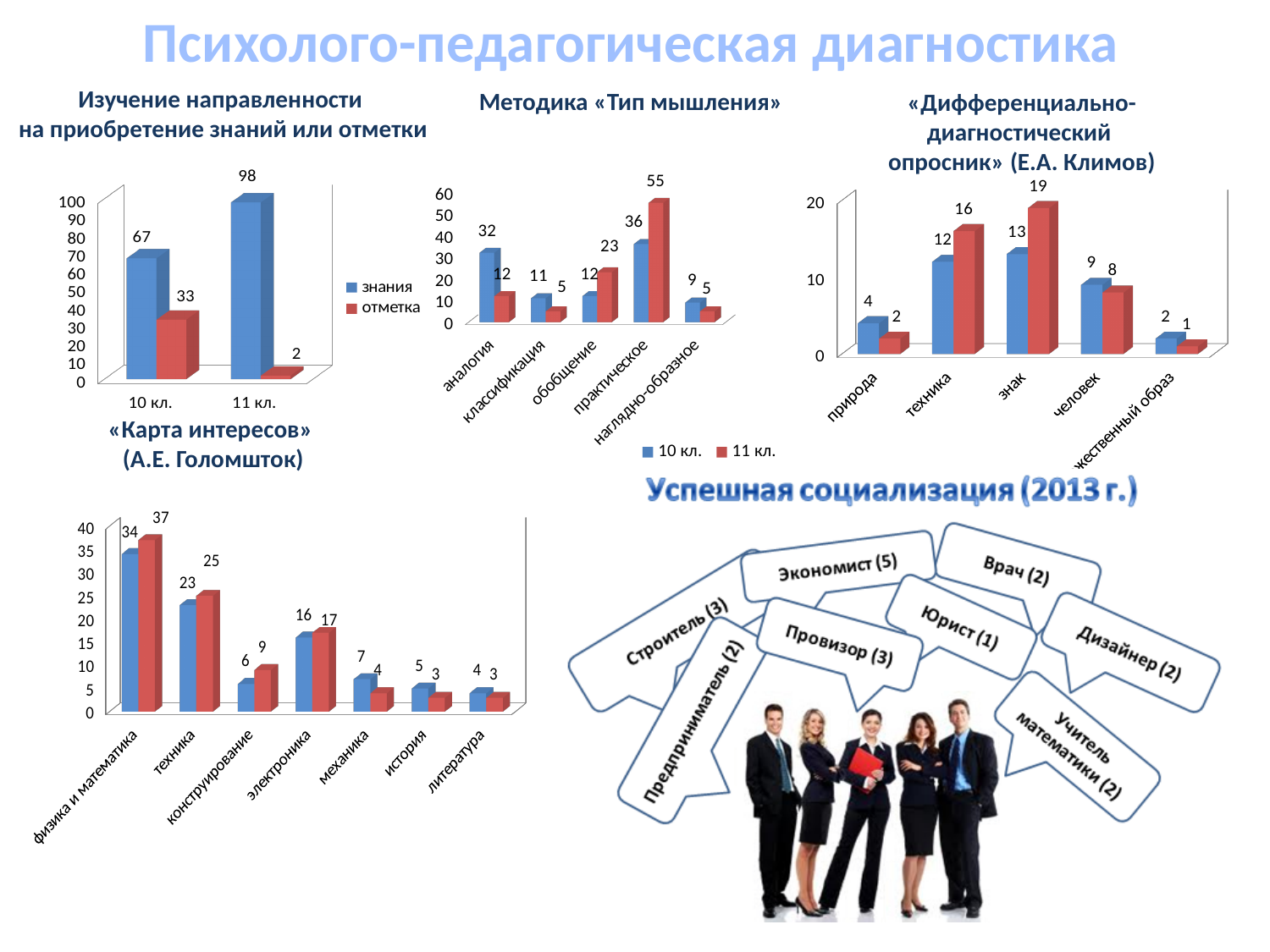
In the chart «Методика «Тип мышления»», how many categories are shown on the x axis? 5 In the chart «Карта интересов» (А.Е. Голомшток), what is the difference between the red and blue bars for «конструирование»? 3 In the chart «Методика «Тип мышления»», which category has the highest value for 10 кл.? практическое In the chart «Карта интересов» (А.Е. Голомшток), what is the value of the red bar for «техника»? 25 In the chart «Дифференциально-диагностический опросник» (Е.А. Климов), what is the value of the red bar for «знак»? 19 In the chart «Дифференциально-диагностический опросник» (Е.А. Климов), which category has the lowest value for the blue bars? художественный образ In the chart «Изучение направленности на приобретение знаний или отметки», how many series does the legend list? 2 In the chart «Методика «Тип мышления»», what is the value for 11 кл. in the category «практическое»? 55 In the chart «Изучение направленности на приобретение знаний или отметки», what is the difference between «знания» and «отметка» for 11 кл.? 96 In the chart «Изучение направленности на приобретение знаний или отметки», what is the value of «знания» for 10 кл.? 67 What type of chart is «Карта интересов» (А.Е. Голомшток)? bar chart In the chart «Методика «Тип мышления»», which is larger for «обобщение»: the value for 10 кл. or for 11 кл.? 11 кл.